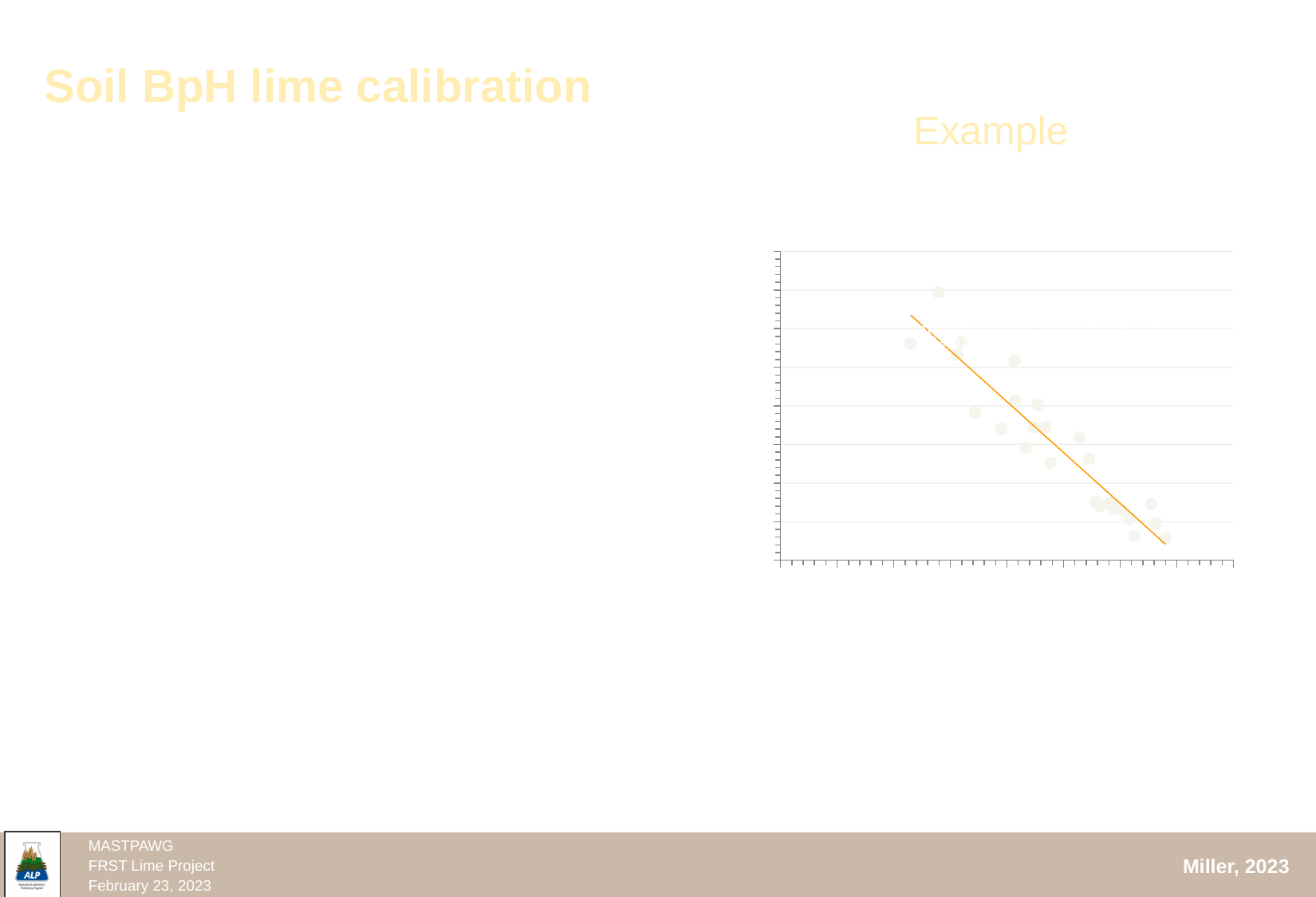
Does the fitted line on the chart slope upward or downward from left to right? downward What colour is the fitted trend line on the chart? orange What kind of chart is shown on the slide? scatter chart Do the plotted points rise or fall as you move from left to right along the x axis? fall